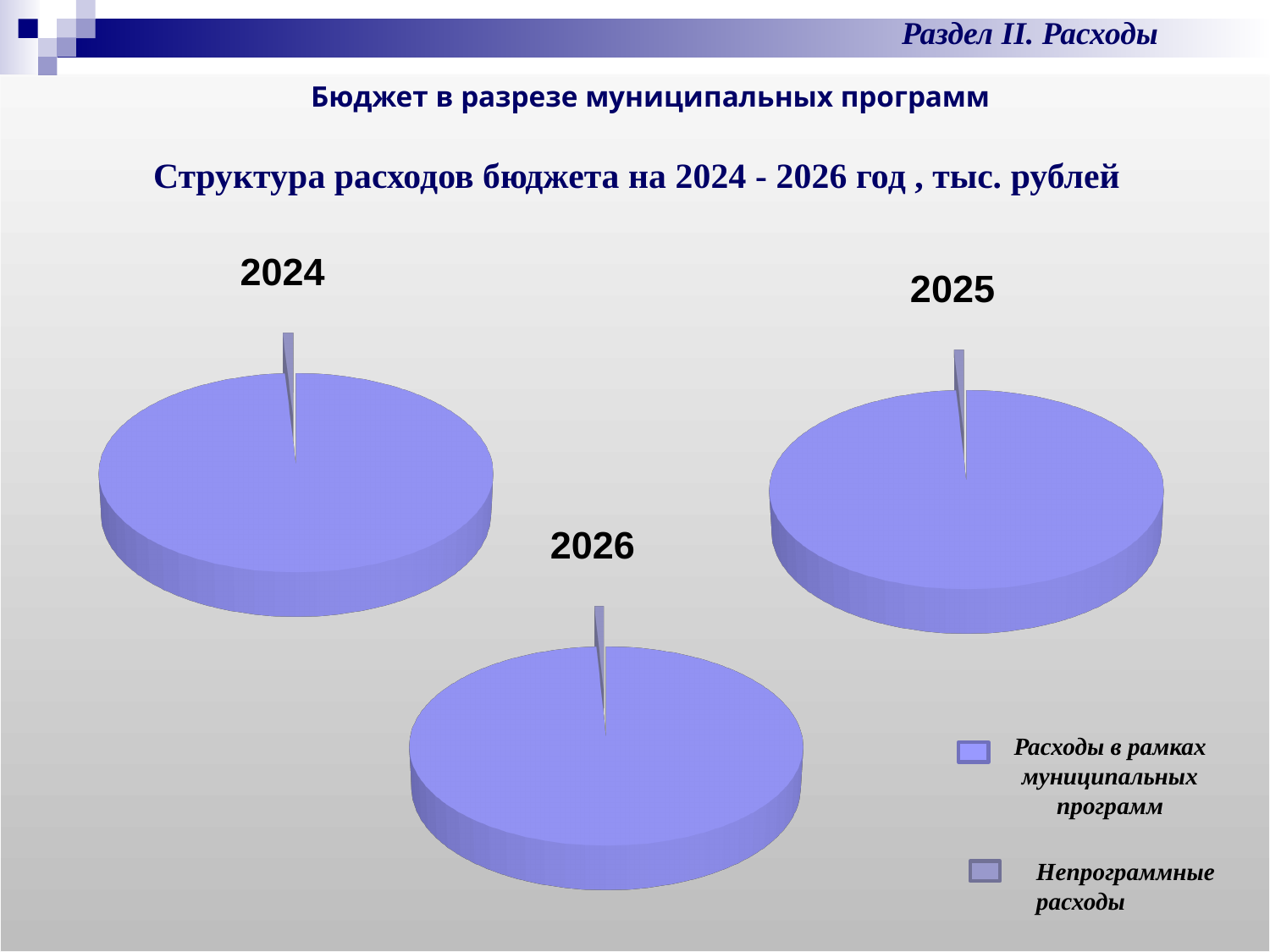
In the 2024 pie chart, which slice is larger: 'Расходы в рамках муниципальных программ' or 'Непрограммные расходы'? Расходы в рамках муниципальных программ In the 2025 pie chart, which slice is smaller: 'Расходы в рамках муниципальных программ' or 'Непрограммные расходы'? Непрограммные расходы In the 2026 pie chart, which category has the smallest share? Непрограммные расходы Which years are the three pie charts labelled with? 2024, 2025, 2026 In the 2025 pie chart, which category has the largest share? Расходы в рамках муниципальных программ What kind of chart is used for the 2024 chart? pie chart How many entries does the legend list? 2 What is the title above the three pie charts? Структура расходов бюджета на 2024 - 2026 год , тыс. рублей In the 2024 pie chart, how many slices are there? 2 How many pie charts are shown on the slide? 3